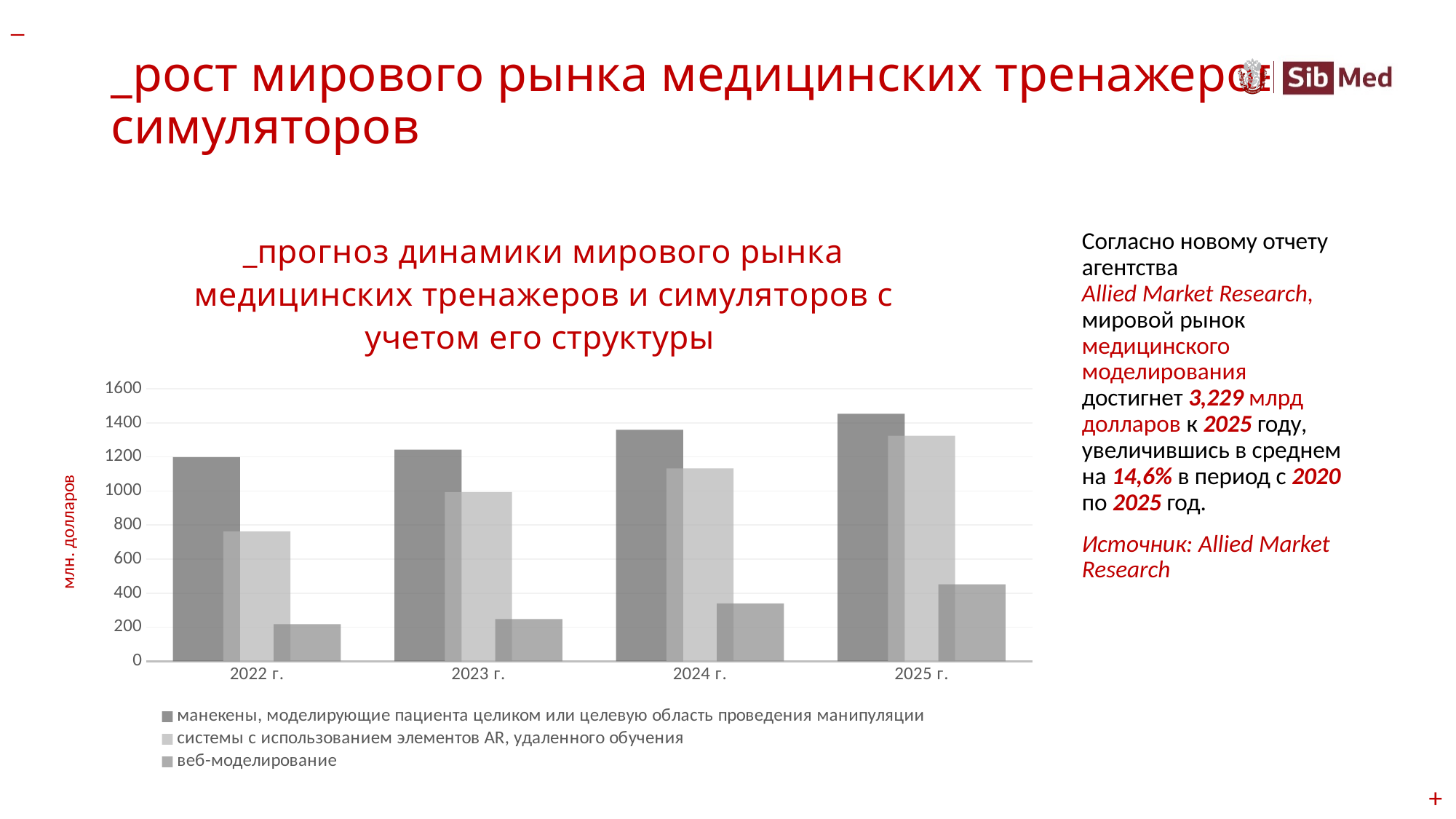
Is the value for 'веб-моделирование' in 2025 г. greater or less than 400? greater How many series does the chart legend list? 3 In 2024 г., which is larger: the value for 'манекены, моделирующие пациента целиком или целевую область проведения манипуляции' or the value for 'системы с использованием элементов AR, удаленного обучения'? манекены, моделирующие пациента целиком или целевую область проведения манипуляции Is the value for 'манекены, моделирующие пациента целиком или целевую область проведения манипуляции' in 2022 г. greater or less than 1000? greater What kind of chart is shown on the slide? bar chart How many years (categories) are shown on the x axis of the chart? 4 Which year has the highest value for the series 'манекены, моделирующие пациента целиком или целевую область проведения манипуляции'? 2025 г. Which year has the lowest value for the series 'веб-моделирование'? 2022 г. Is the value for 'веб-моделирование' in 2024 г. greater or less than 400? less What is the label on the vertical axis of the chart? млн. долларов Do the values for 'системы с использованием элементов AR, удаленного обучения' rise or fall from 2022 г. to 2025 г.? rise